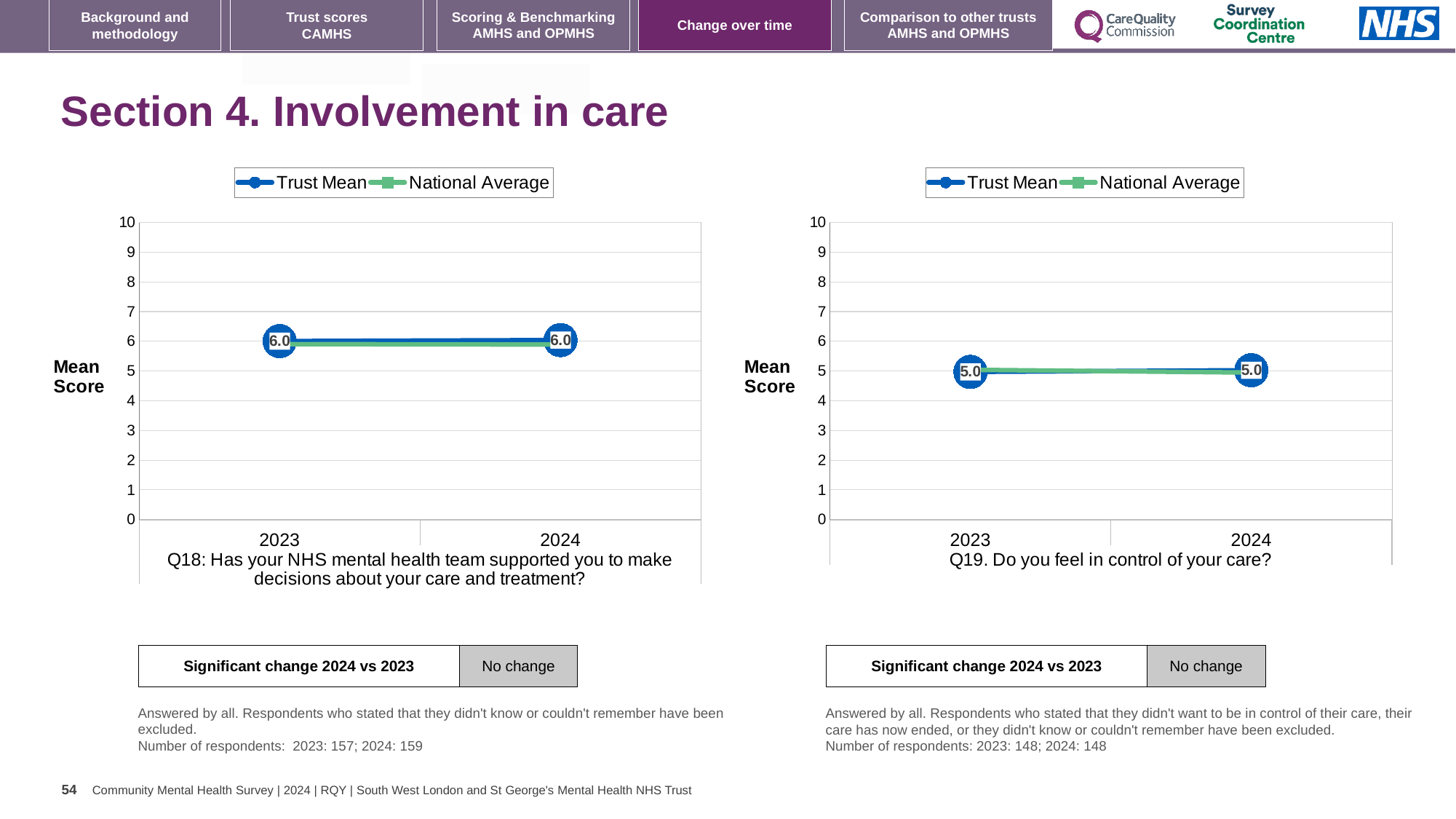
In the Q19 chart, is the National Average for 2023 greater or less than 7? less What kind of chart is the Q18 chart? line chart How many years are plotted on the x axis of the Q18 chart? 2 In the Q19 chart, does the Trust Mean rise, fall or stay flat from 2023 to 2024? stays flat In the Q19 chart, what is the Trust Mean score for 2024? 5.0 What does the box below the Q19 chart say about significant change 2024 vs 2023? No change In the Q18 chart, what is the Trust Mean score for 2023? 6.0 In the Q19 chart, what is the Trust Mean score for 2023? 5.0 How many series does the legend of the Q19 chart list? 2 In the Q18 chart, is the National Average for 2024 greater or less than 4? greater In the Q18 chart, what is the difference between the Trust Mean scores for 2024 and 2023? 0.0 In the Q18 chart, what is the Trust Mean score for 2024? 6.0